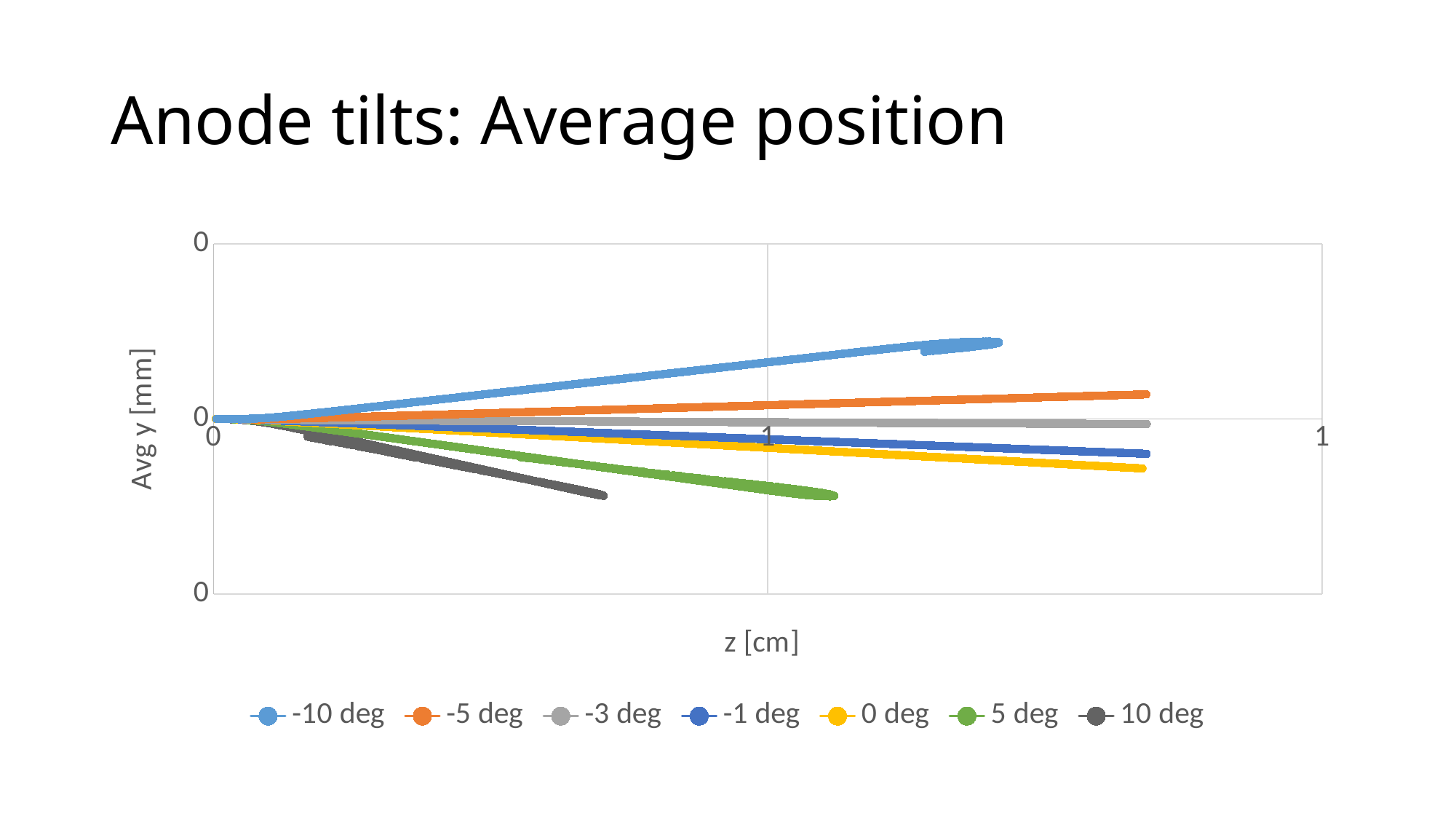
Which series is higher at its end point: -10 deg or -5 deg? -10 deg What kind of chart is shown on the slide? scatter chart Does the 10 deg series rise or fall as z increases? fall How many series does the legend list? 7 Which series ends at the smallest z value? 10 deg At the right end of the lines, which series is lower: 5 deg or 0 deg? 5 deg What is the title of the y axis? Avg y [mm] What is the title of the x axis? z [cm] Which series reaches the highest Avg y value? -10 deg At the right end of the lines, which series is higher: -5 deg or -1 deg? -5 deg Does the -10 deg series rise or fall as z increases? rise Does the 0 deg series rise or fall as z increases? fall